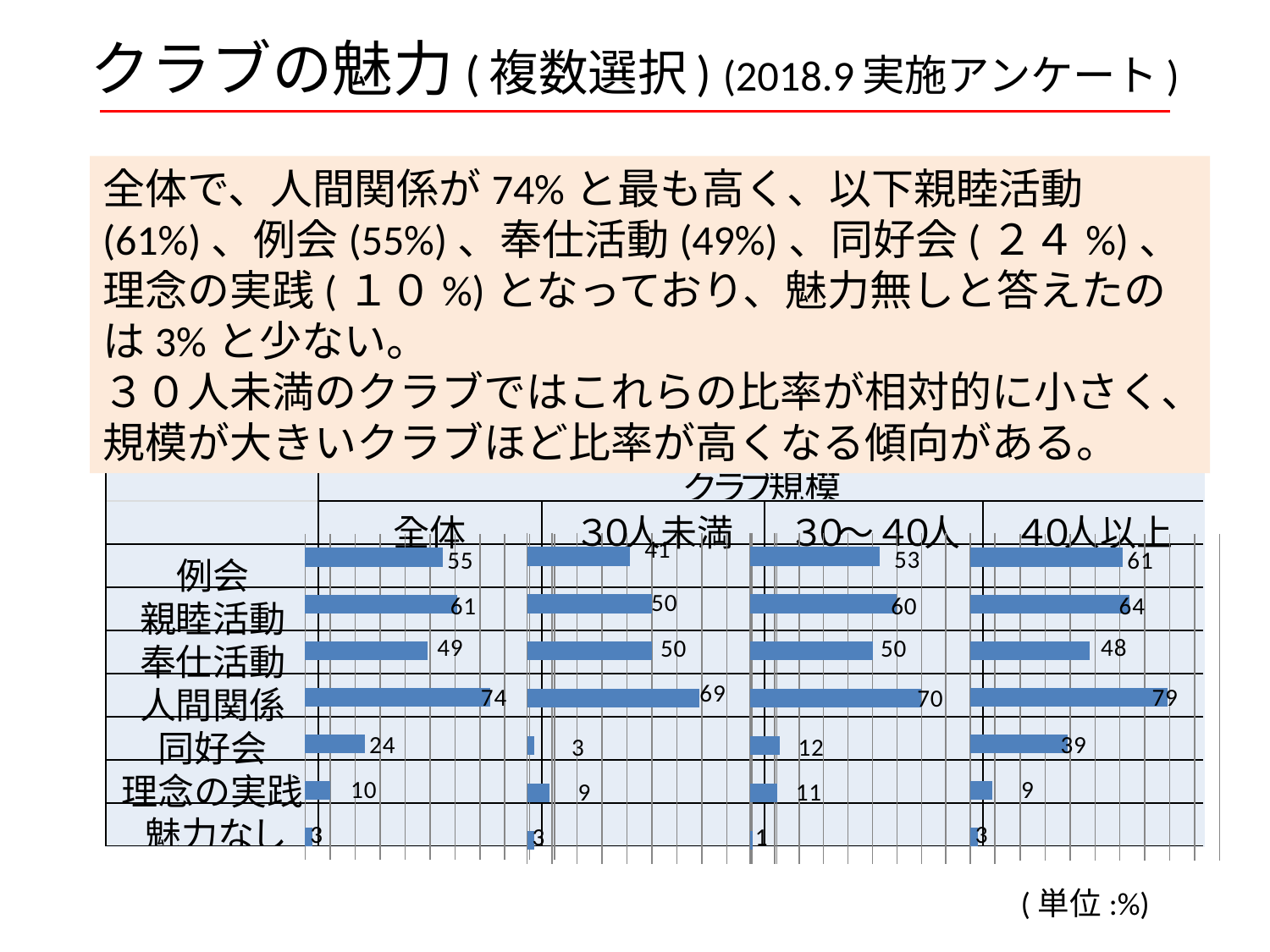
What type of chart is shown on the slide? Bar chart In the 30～40人 panel, what is the value for 魅力なし? 1 In the 全体 panel, what is the value for 人間関係? 74 In the 40人以上 panel, what is the value for 同好会? 39 In the 全体 panel, which category has the highest value? 人間関係 Which is larger: 同好会 in the 30～40人 panel or 同好会 in the 40人以上 panel? 40人以上 In the 30人未満 panel, what is the value for 例会? 41 What is the difference between the 人間関係 values in the 40人以上 panel and the 30人未満 panel? 10 How many categories are shown on the vertical axis of the chart? 7 How many club-size groups (panels) does the chart show? 4 In the 全体 panel, what is the difference between 親睦活動 and 例会? 6 In the 40人以上 panel, which category has the lowest value? 魅力なし